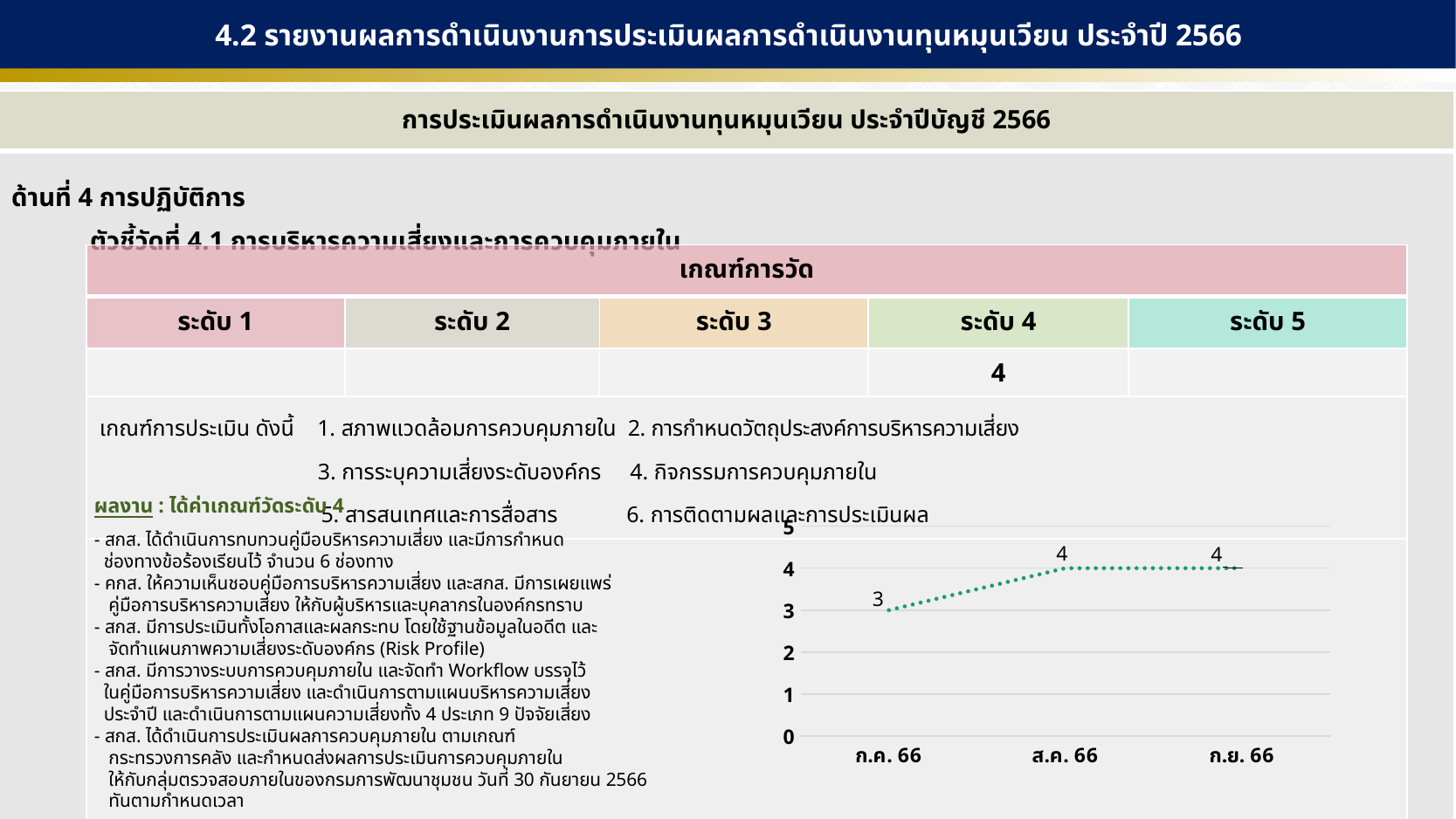
What is the value for ส.ค. 66 in the line chart? 4 How many data points are plotted in the line chart? 3 What is the difference between the values for ส.ค. 66 and ก.ค. 66 in the line chart? 1 What colour is the line in the chart? green Which month has the lowest value in the line chart? ก.ค. 66 What is the highest value shown on the y axis of the line chart? 5 Is the value for ก.ค. 66 in the line chart greater or less than 4? less What kind of chart is shown on the slide? line chart What is the value for ก.ย. 66 in the line chart? 4 Which is larger in the line chart, the value for ก.ค. 66 or the value for ส.ค. 66? ส.ค. 66 Do the values in the line chart rise or fall from ก.ค. 66 to ส.ค. 66? rise What is the value for ก.ค. 66 in the line chart? 3